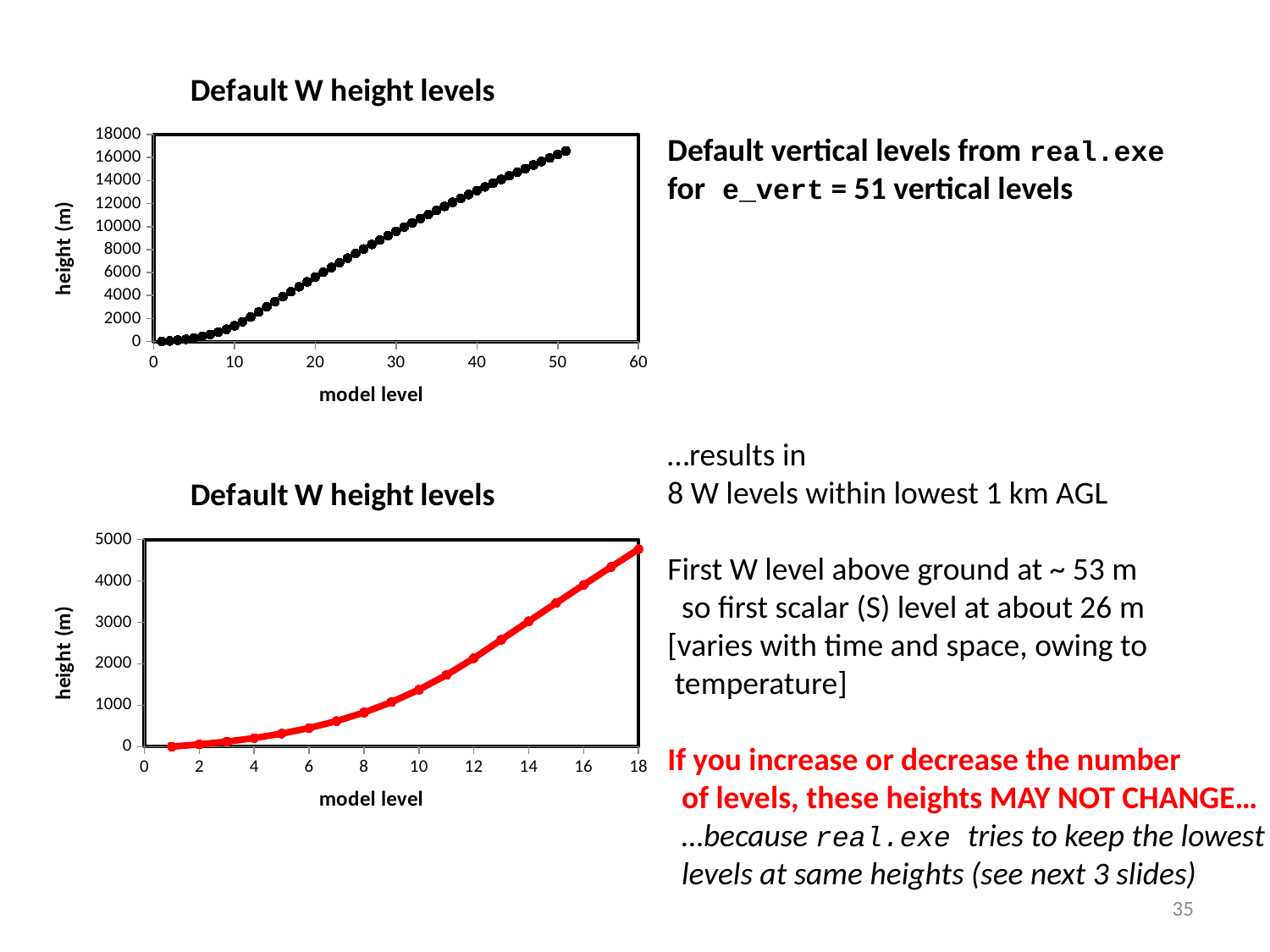
What is the title of the top chart? Default W height levels What kind of chart is the bottom chart on the slide? line chart In the bottom chart, is the height at model level 6 greater or less than 1000? less In the top chart, do the height values rise or fall as model level increases? rise What is the y-axis label of the bottom chart? height (m) In the bottom chart, do the height values rise or fall as model level increases? rise In the top chart, is the height at model level 30 greater or less than 8000? greater In the bottom chart, is the height at model level 18 greater or less than 4000? greater What kind of chart is the top chart on the slide? scatter chart